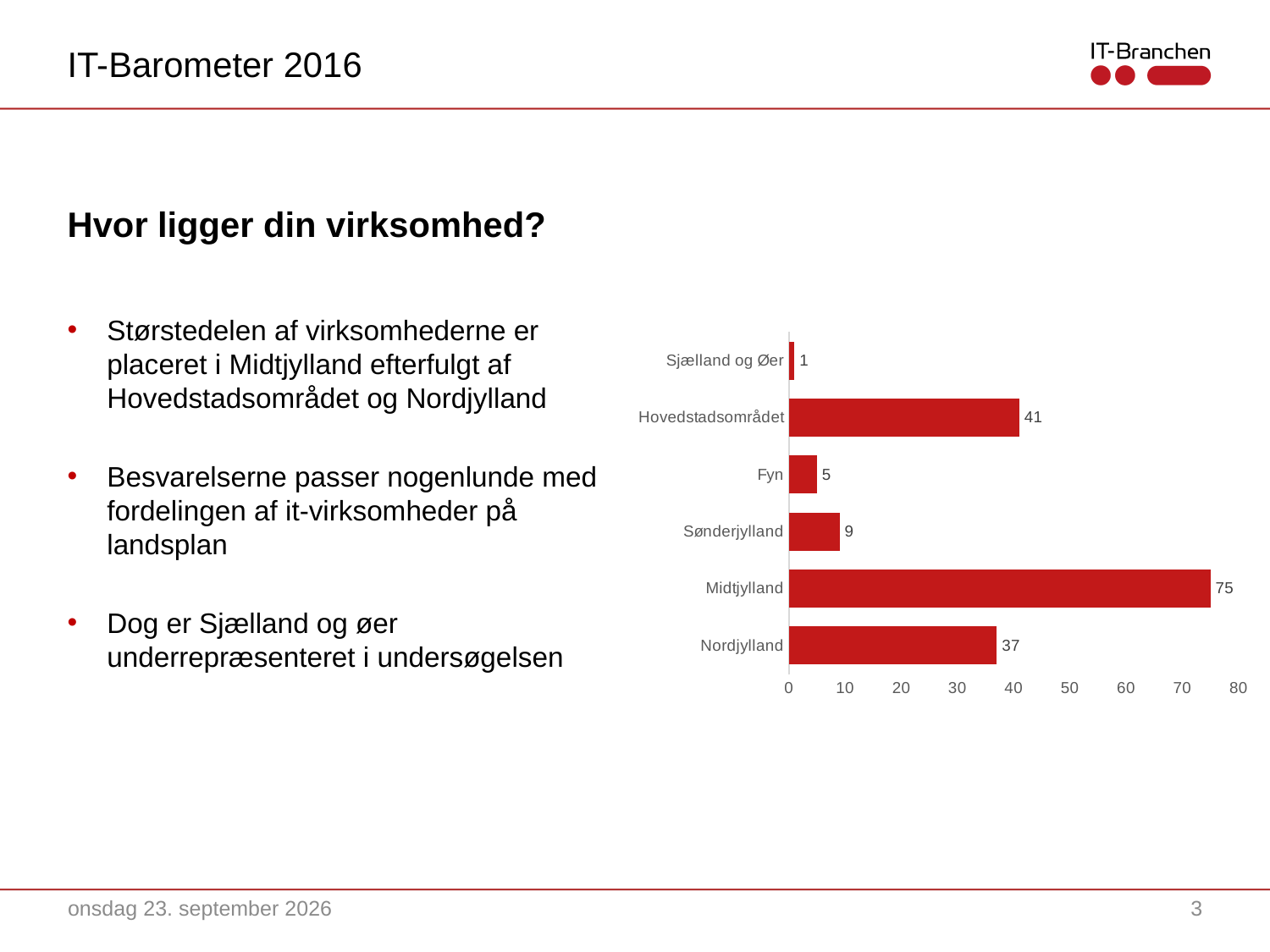
What is the value for Sjælland og Øer? 1 Which region has the lowest value? Sjælland og Øer What is the value for Hovedstadsområdet? 41 What is the value for Sønderjylland? 9 Which region has the highest value? Midtjylland What is the difference between the values for Hovedstadsområdet and Fyn? 36 What is the value for Midtjylland? 75 Which is larger, the value for Hovedstadsområdet or the value for Nordjylland? Hovedstadsområdet How many regions are shown in the chart? 6 What is the difference between the values for Midtjylland and Nordjylland? 38 What is the highest value shown on the x axis of the chart? 80 What kind of chart is shown on the slide? Bar chart